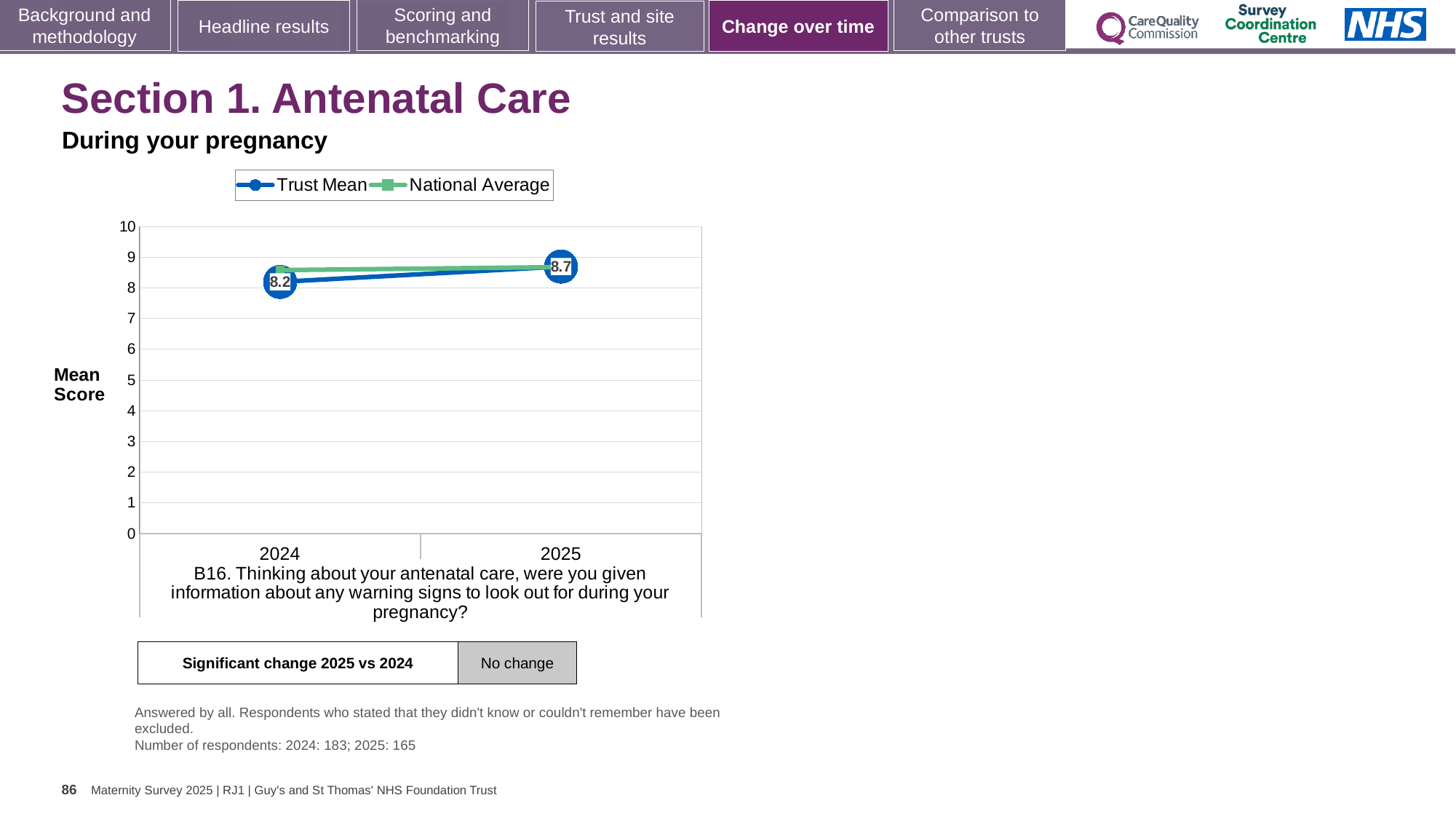
Does the Trust Mean rise or fall from 2024 to 2025? rise How many years are shown on the x axis? 2 What kind of chart is shown on the slide? line chart What is the label on the y axis of the chart? Mean Score What are the two series named in the legend? Trust Mean and National Average Which year has the higher Trust Mean, 2024 or 2025? 2025 What is the difference between the Trust Mean in 2025 and in 2024? 0.5 What is the Trust Mean value for 2024? 8.2 Is the National Average value for 2024 greater or less than 8? greater How many series does the legend list? 2 In 2024, which is higher, the Trust Mean or the National Average? National Average What is the Trust Mean value for 2025? 8.7